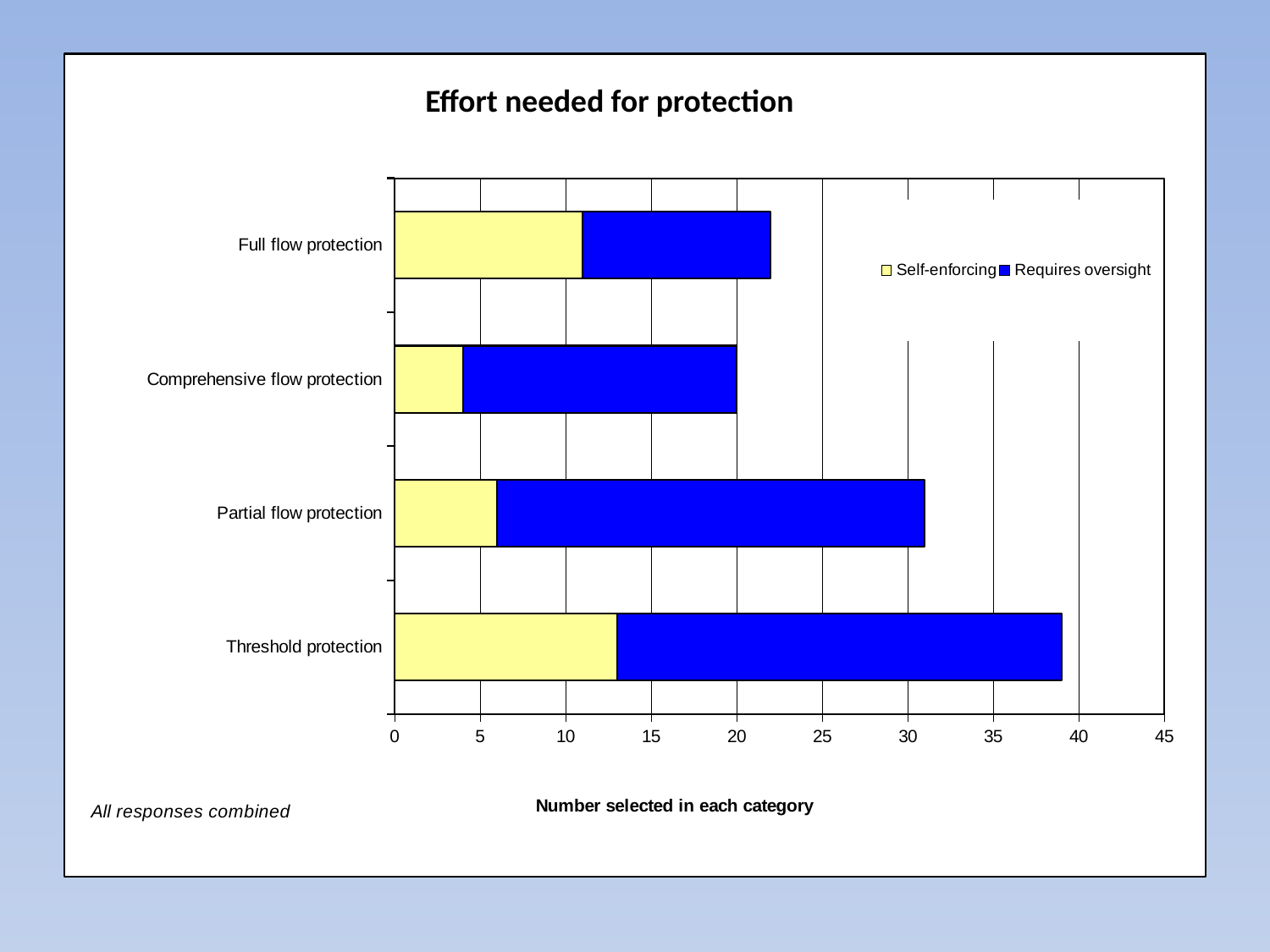
Is the Self-enforcing value for Comprehensive flow protection greater or less than 5? less What is the title of the chart? Effort needed for protection Which category has the longest total bar? Threshold protection Is the Self-enforcing value for Threshold protection greater or less than 10? greater Is the total bar for Threshold protection greater or less than 35? greater Which has the longer total bar, Partial flow protection or Full flow protection? Partial flow protection What is the label of the horizontal axis? Number selected in each category What kind of chart is shown on the slide? Stacked bar chart How many series does the legend list? 2 Which category has the smallest Self-enforcing value? Comprehensive flow protection How many categories are shown on the chart? 4